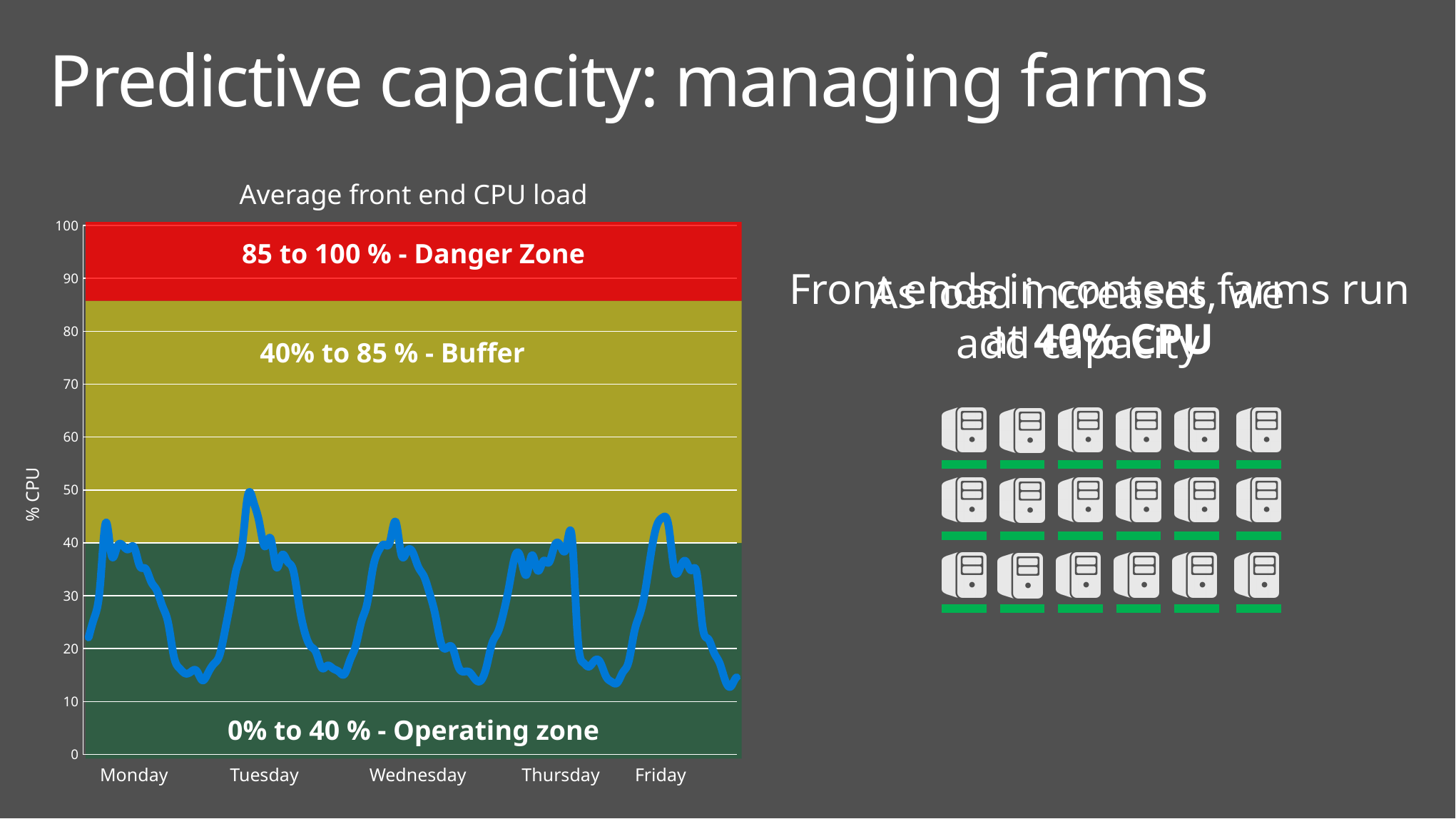
How many days are labelled on the x axis of the chart? 5 Does the CPU load line ever reach the Danger Zone (85 to 100 %)? No Is the lowest value on Wednesday greater or less than 20? less Is the peak value on Friday greater or less than 40? greater What kind of chart is shown on the slide? line chart Which range of CPU load is labelled as the Danger Zone on the chart? 85 to 100 % What is the title of the chart? Average front end CPU load Does the CPU load rise steadily, fall steadily, or fluctuate across the week? fluctuate Which day shows the highest peak CPU load on the chart? Tuesday